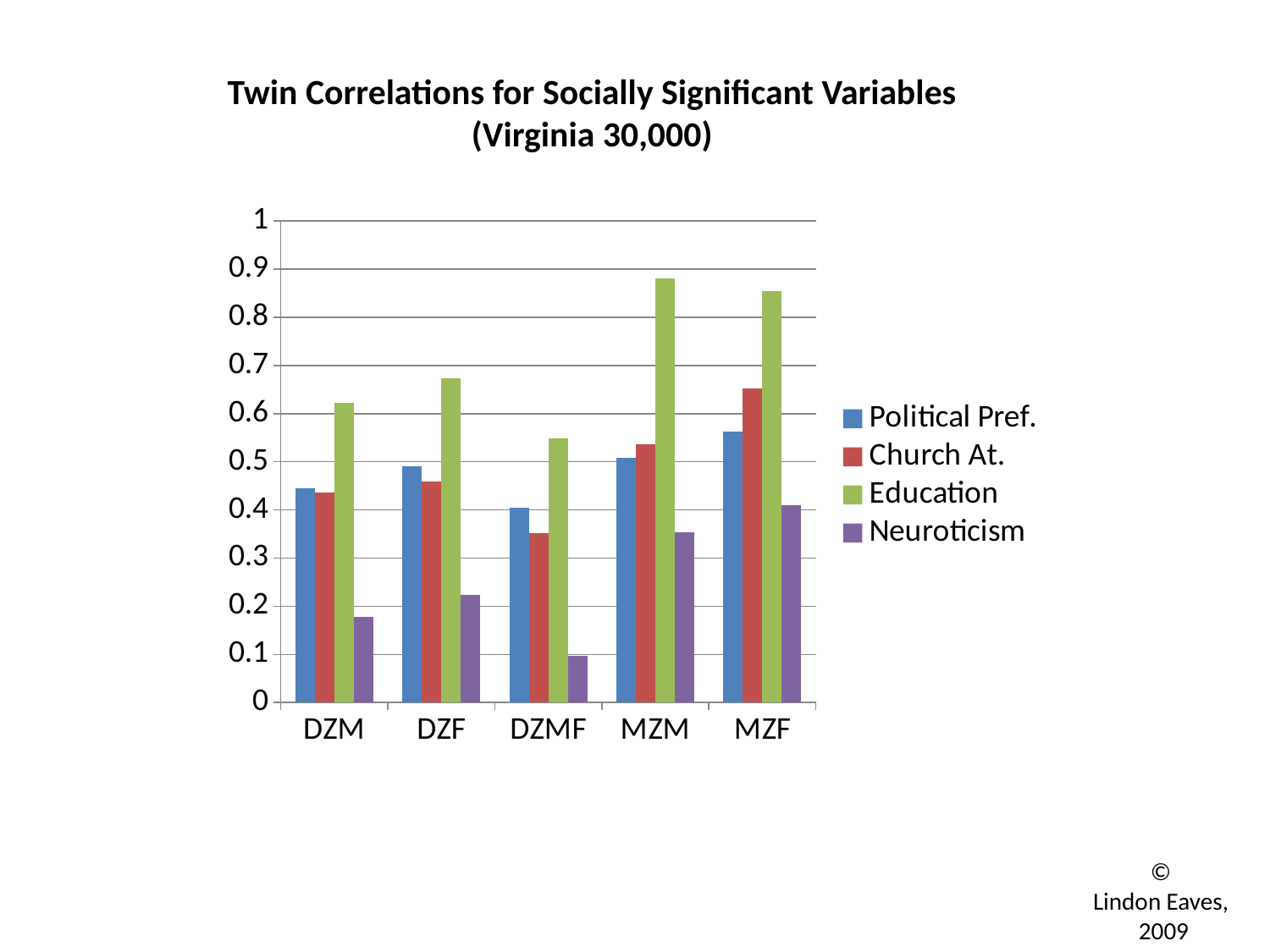
Which category has the lowest Church At. correlation? DZMF Is the Neuroticism value for DZMF greater or less than 0.2? less What kind of chart is shown on the slide? Bar chart Which colour represents the Education series in the legend? Green How many twin-group categories are shown on the x axis? 5 Which category has the lowest Neuroticism correlation? DZMF Which category has the highest Neuroticism correlation? MZF Is the Church At. value for MZF greater or less than 0.6? greater For DZM, which is larger: the Education value or the Neuroticism value? Education Is the Education value for MZM greater or less than 0.8? greater For MZF, which is larger: the Church At. value or the Political Pref. value? Church At. How many series does the legend list? 4